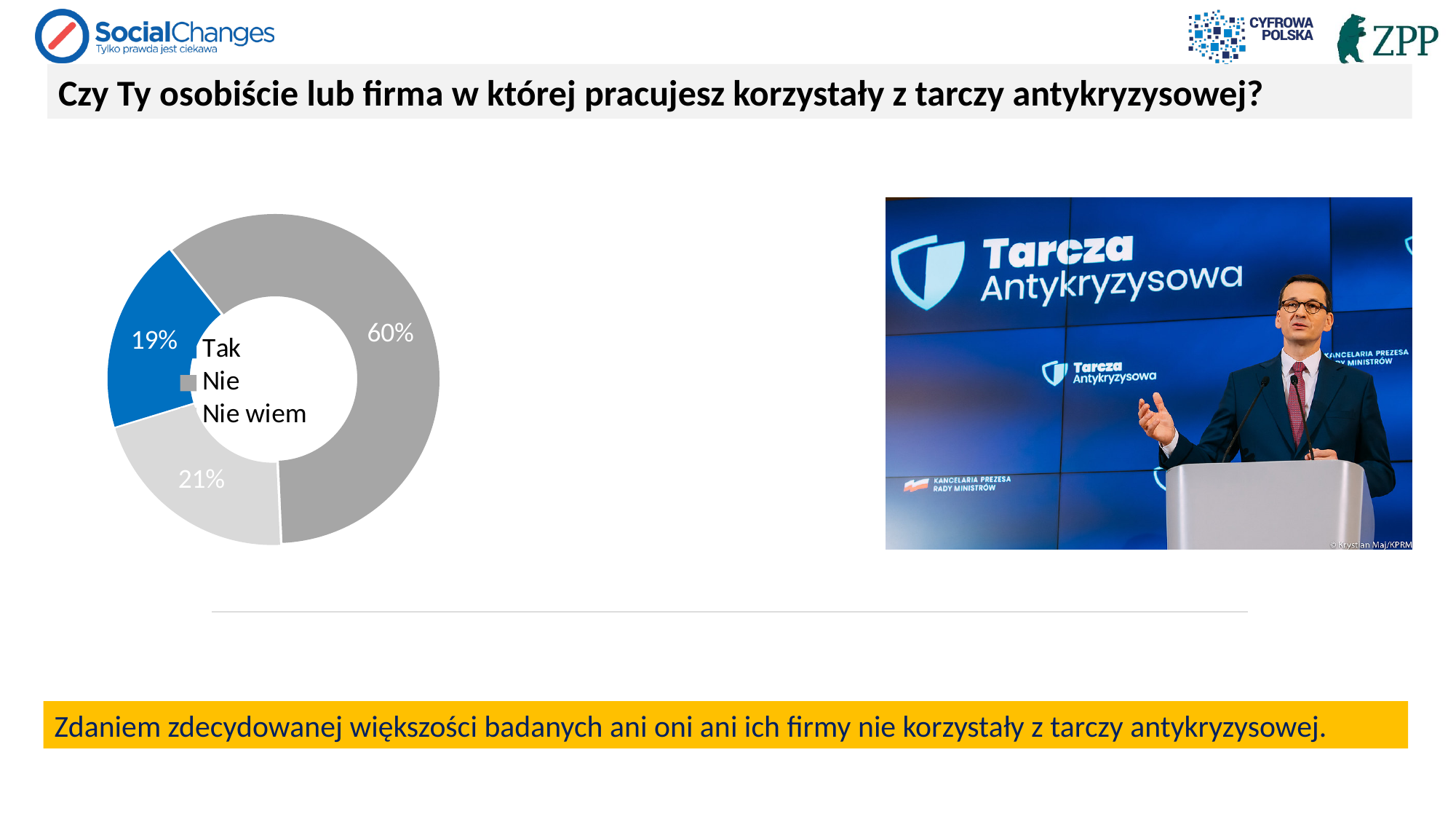
What is the difference in percentage points between "Nie" and "Tak"? 41 What is the difference in percentage points between "Nie wiem" and "Tak"? 2 Which answer has the largest share of the chart? Nie What percentage of respondents answered "Tak"? 19% What kind of chart is shown on the slide? Doughnut (pie) chart What percentage of respondents answered "Nie wiem"? 21% What question does the chart on the slide answer? Czy Ty osobiście lub firma w której pracujesz korzystały z tarczy antykryzysowej? Which is larger, the share for "Nie" or the share for "Nie wiem"? Nie How many answer categories are shown in the chart? 3 What percentage of respondents answered "Nie"? 60% What colour is the slice representing "Tak"? Blue Which answer has the smallest share of the chart? Tak